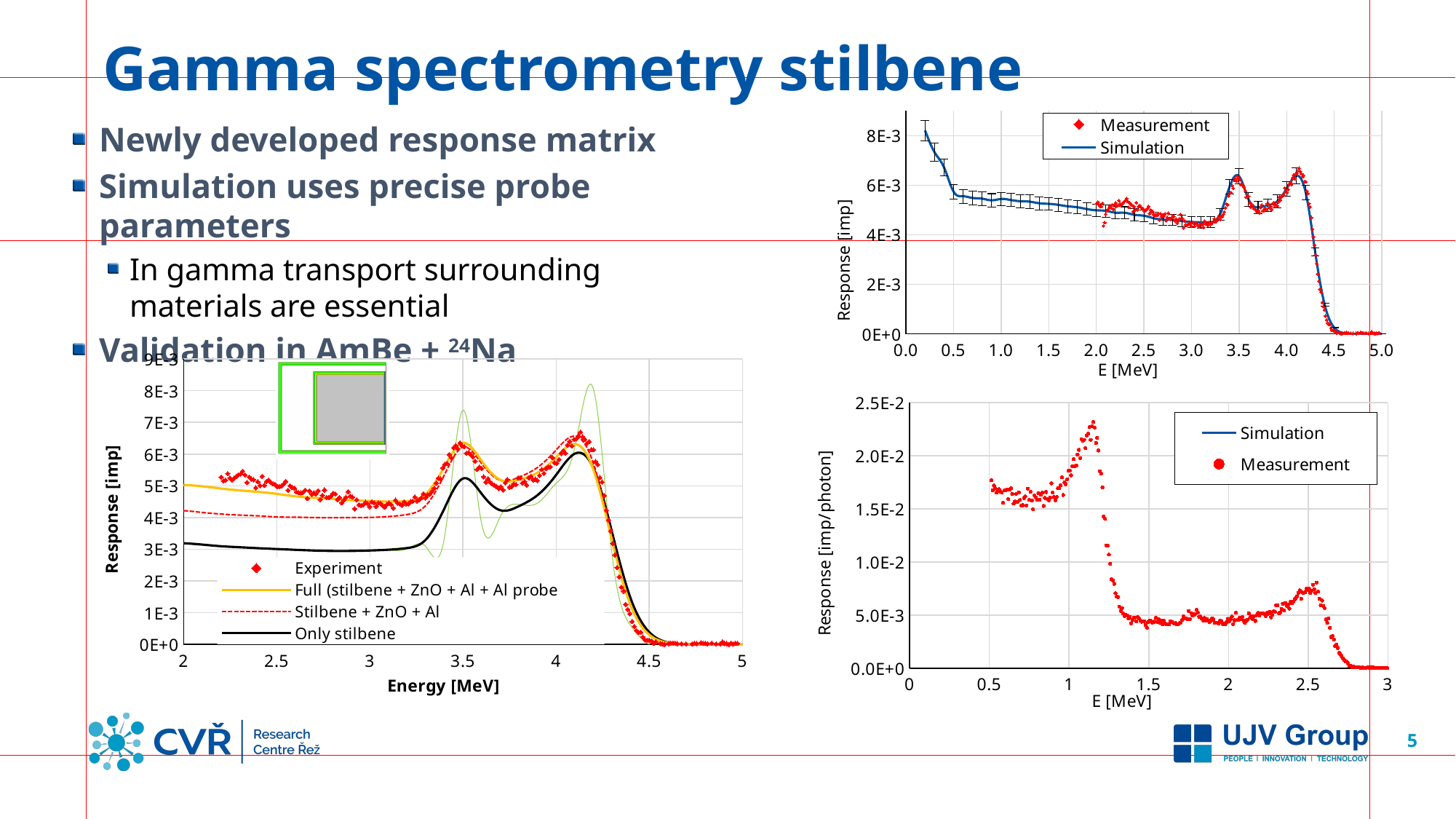
On the bottom-left chart, how many series does the legend list? 4 On the bottom-right chart, is the Measurement value at 2 MeV greater or less than 1.0E-2? less On the bottom-left chart, at 2.5 MeV, which is larger: the Full (stilbene + ZnO + Al + Al probe) series or the Only stilbene series? Full (stilbene + ZnO + Al + Al probe) On the top-right chart, do the Simulation values rise or fall between 4.0 and 5.0 MeV? fall What is the y-axis label of the bottom-right chart? Response [imp/photon] On the top-right chart, is the Simulation value at 0.5 MeV greater or less than 4E-3? greater What is the x-axis label of the bottom-left chart? Energy [MeV] On the top-right chart, how many series does the legend list? 2 On the bottom-right chart, how many series does the legend list? 2 What kind of chart is the bottom-left chart? line chart On the bottom-left chart, is the Only stilbene value at 2.5 MeV greater or less than 4E-3? less